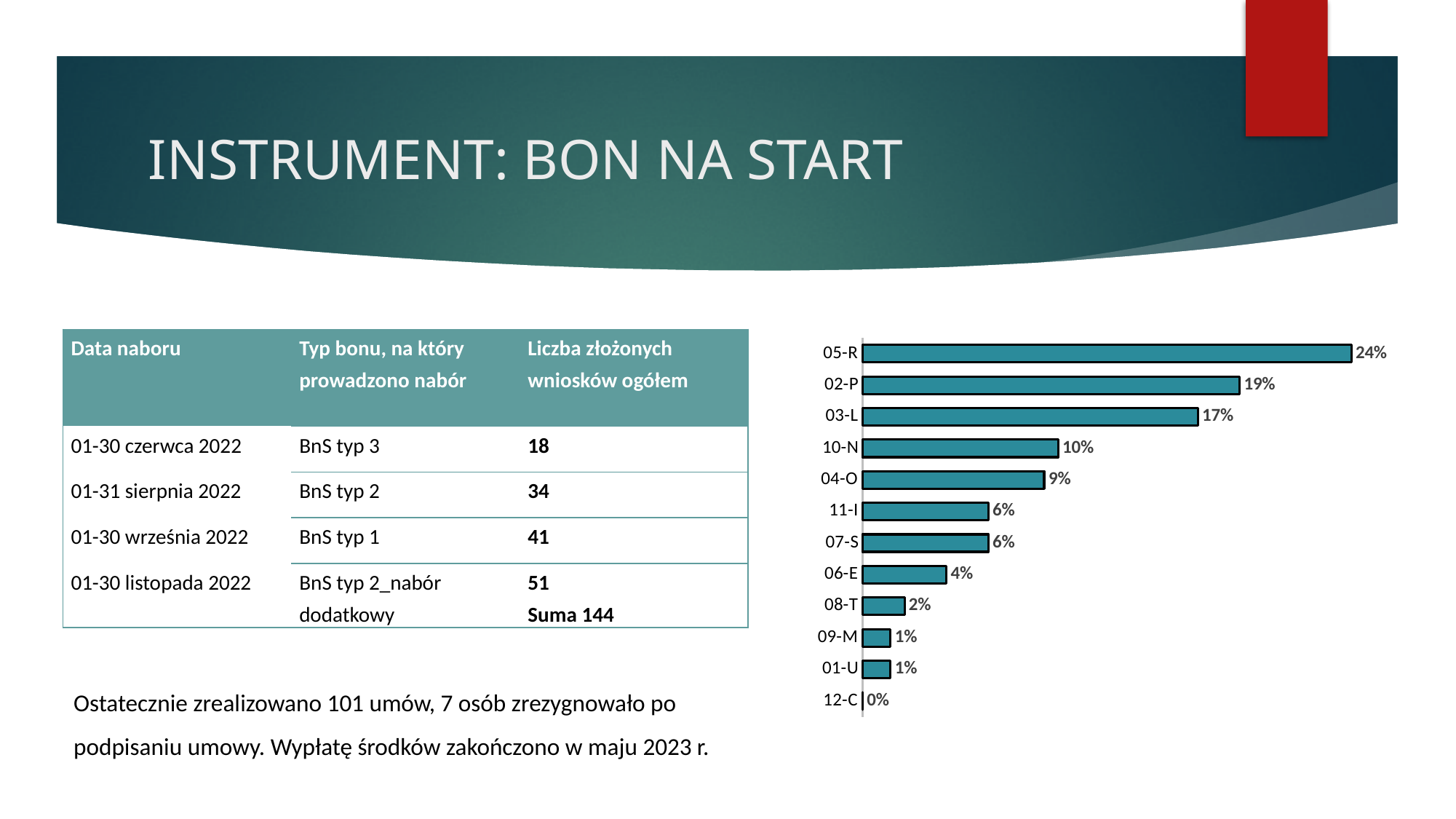
Which category has the lowest value in the bar chart? 12-C How many categories are plotted in the bar chart? 12 What is the value shown for 05-R in the bar chart? 24% What is the value shown for 06-E in the bar chart? 4% What kind of chart is shown on the right side of the slide? bar chart What is the value shown for 10-N in the bar chart? 10% What is the value shown for 12-C in the bar chart? 0% What is the difference between the values for 05-R and 02-P in the bar chart? 5% Which category has the highest value in the bar chart? 05-R Which has a larger value in the bar chart, 03-L or 10-N? 03-L Do the bar values increase or decrease going from the top category to the bottom category in the bar chart? decrease What is the difference between the values for 03-L and 04-O in the bar chart? 8%